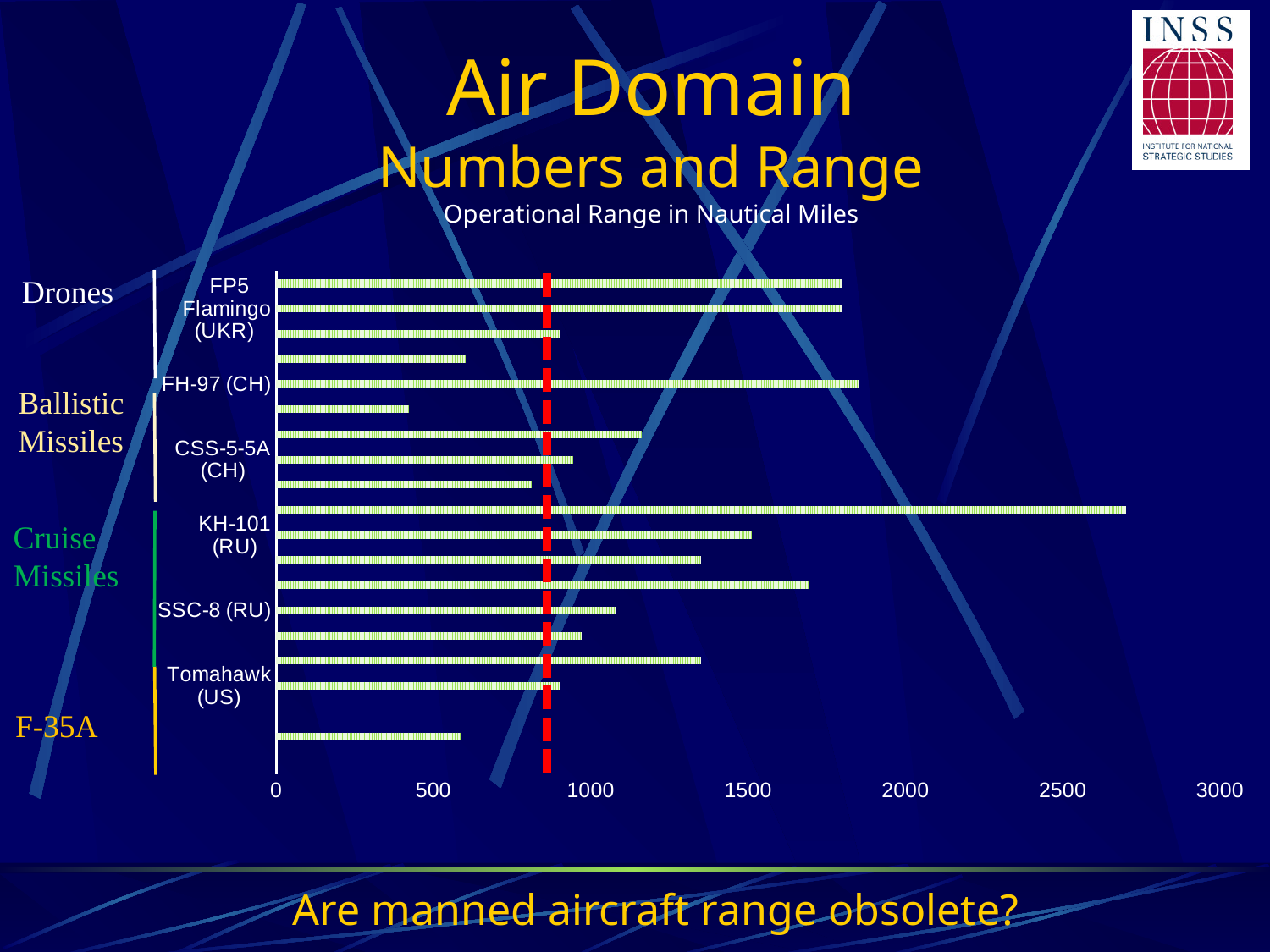
Which has the larger value, FP5 Flamingo (UKR) or Tomahawk (US)? FP5 Flamingo (UKR) Which has the larger value, KH-101 (RU) or SSC-8 (RU)? KH-101 (RU) Is the value for SSC-8 (RU) greater or less than 1500? less What kind of chart is shown on the slide? bar chart What is the highest value shown on the x axis of the chart? 3000 Is the value for Tomahawk (US) greater or less than 1000? less Is the value for FH-97 (CH) greater or less than 1500? greater How many named weapon systems are labeled on the chart's vertical axis? 6 What is the subtitle describing the units of the chart? Operational Range in Nautical Miles